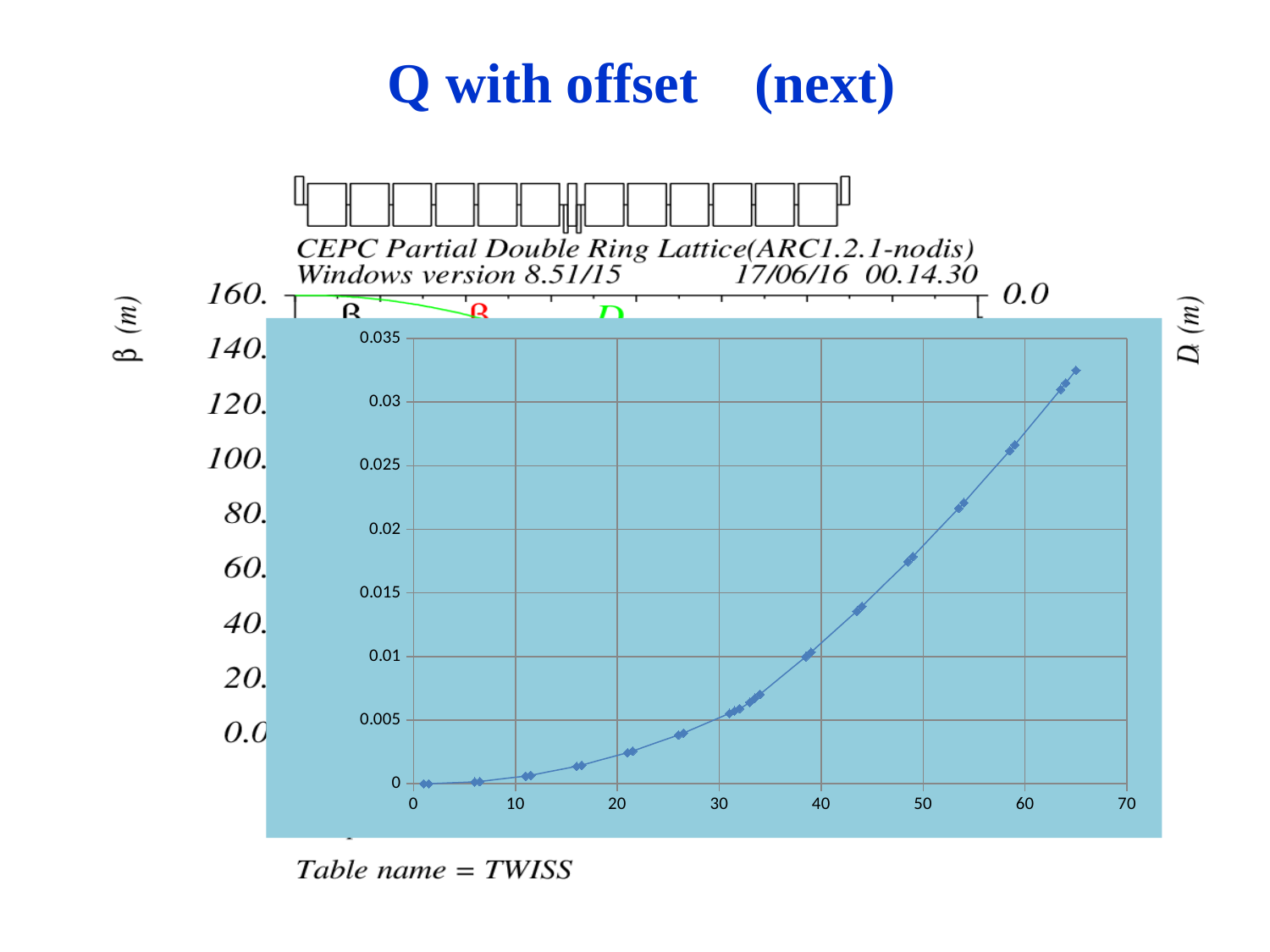
In the chart with the light blue background, which point has the lowest value, the leftmost or the rightmost? the leftmost In the chart with the light blue background, is the value of the point near x = 59 greater or less than 0.025? greater What kind of chart is the overlaid chart with the light blue background? line chart with markers In the chart with the light blue background, do the plotted values rise or fall as x increases from 0 to 65? rise In the chart with the light blue background, what is the highest tick label on the y axis? 0.035 In the chart with the light blue background, is the value of the point near x = 26 greater or less than 0.005? less In the chart with the light blue background, which point has the highest value, the leftmost or the rightmost? the rightmost In the chart with the light blue background, is the value of the point near x = 44 greater or less than 0.015? less In the chart with the light blue background, what is the highest tick label on the x axis? 70